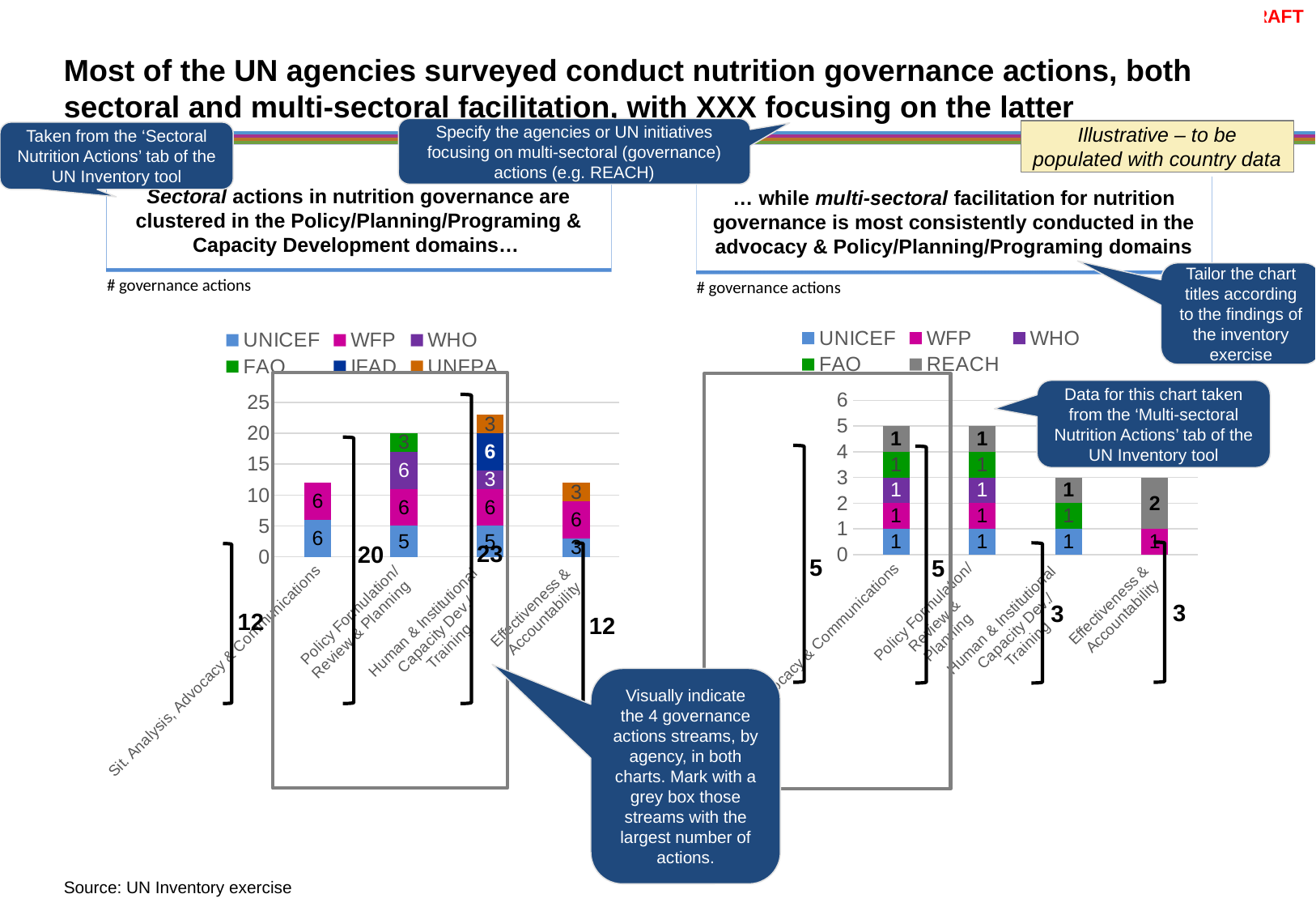
In the left chart on sectoral actions, how many series does the legend list? 6 In the left chart on sectoral actions, which category has the highest total number of governance actions? Human & Institutional Capacity Dev / Training In the right chart on multi-sectoral facilitation, what is the REACH value for Effectiveness & Accountability? 2 In the left chart on sectoral actions, what is the UNICEF value for Policy Formulation/Review & Planning? 5 In the right chart on multi-sectoral facilitation, how many series does the legend list? 5 In the left chart on sectoral actions, what is the IFAD value for Human & Institutional Capacity Dev / Training? 6 In the left chart on sectoral actions, what is the difference between the totals for Policy Formulation/Review & Planning and Effectiveness & Accountability? 8 What kind of chart is the left chart on sectoral actions? Stacked bar chart In the right chart on multi-sectoral facilitation, what is the total for Policy Formulation/Review & Planning? 5 How many categories are shown on the x axis of the right chart on multi-sectoral facilitation? 4 In the right chart on multi-sectoral facilitation, which is larger: the total for Policy Formulation/Review & Planning or the total for Human & Institutional Capacity Dev / Training? Policy Formulation/Review & Planning In the left chart on sectoral actions, what is the total number of governance actions for Human & Institutional Capacity Dev / Training? 23